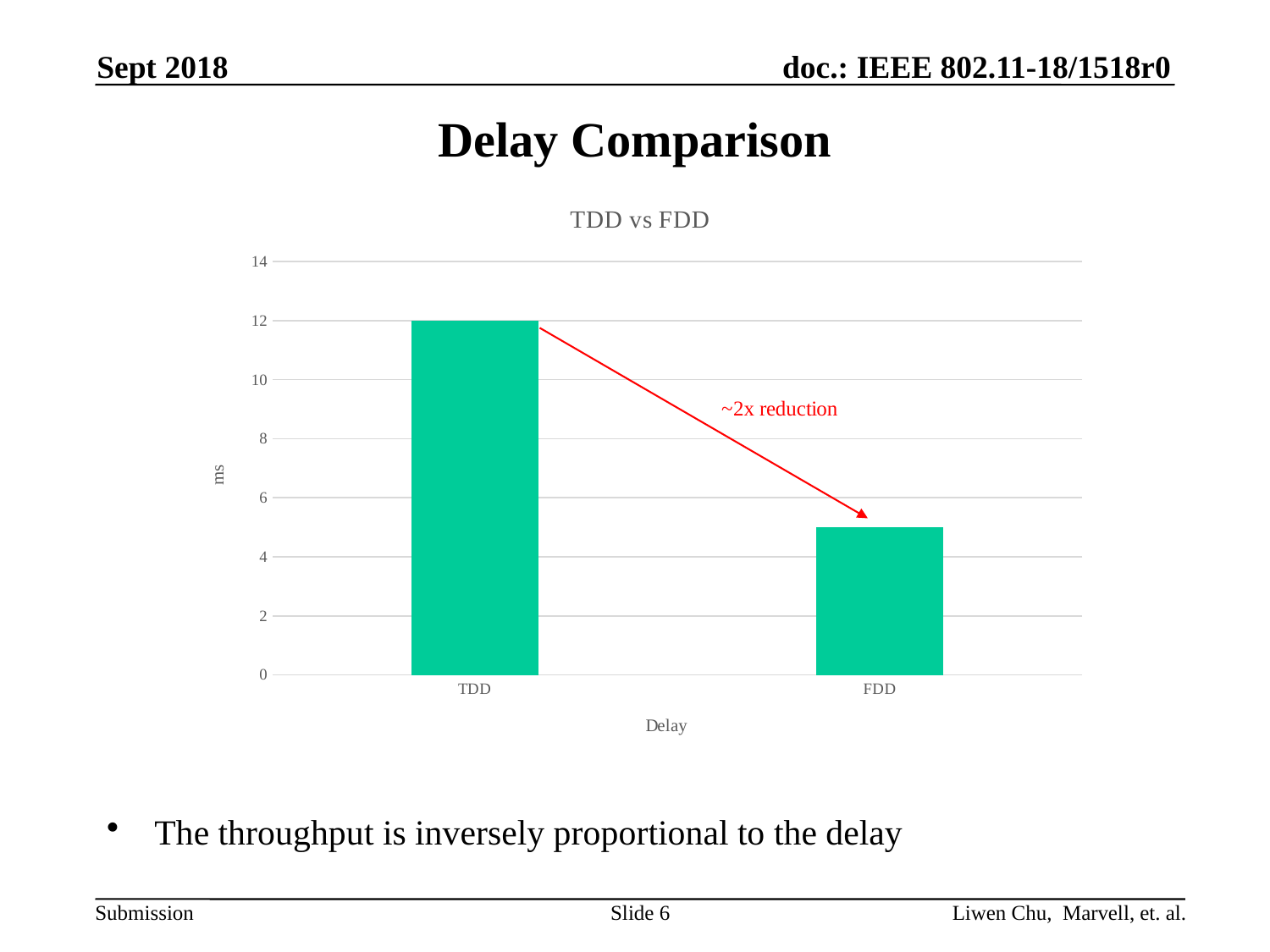
How many categories are shown on the x axis? 2 Which category has the lowest delay? FDD Is the value for FDD greater or less than 6? less Is the value for FDD greater or less than 4? greater What type of chart is shown on the slide? bar chart Do the values rise or fall from TDD to FDD along the x axis? fall What is the title of the chart? TDD vs FDD What is the delay value for TDD in ms? 12 Is the value for TDD greater or less than 10? greater Which category has the highest delay? TDD What is the label of the y axis? ms Is the delay for TDD larger or smaller than the delay for FDD? larger